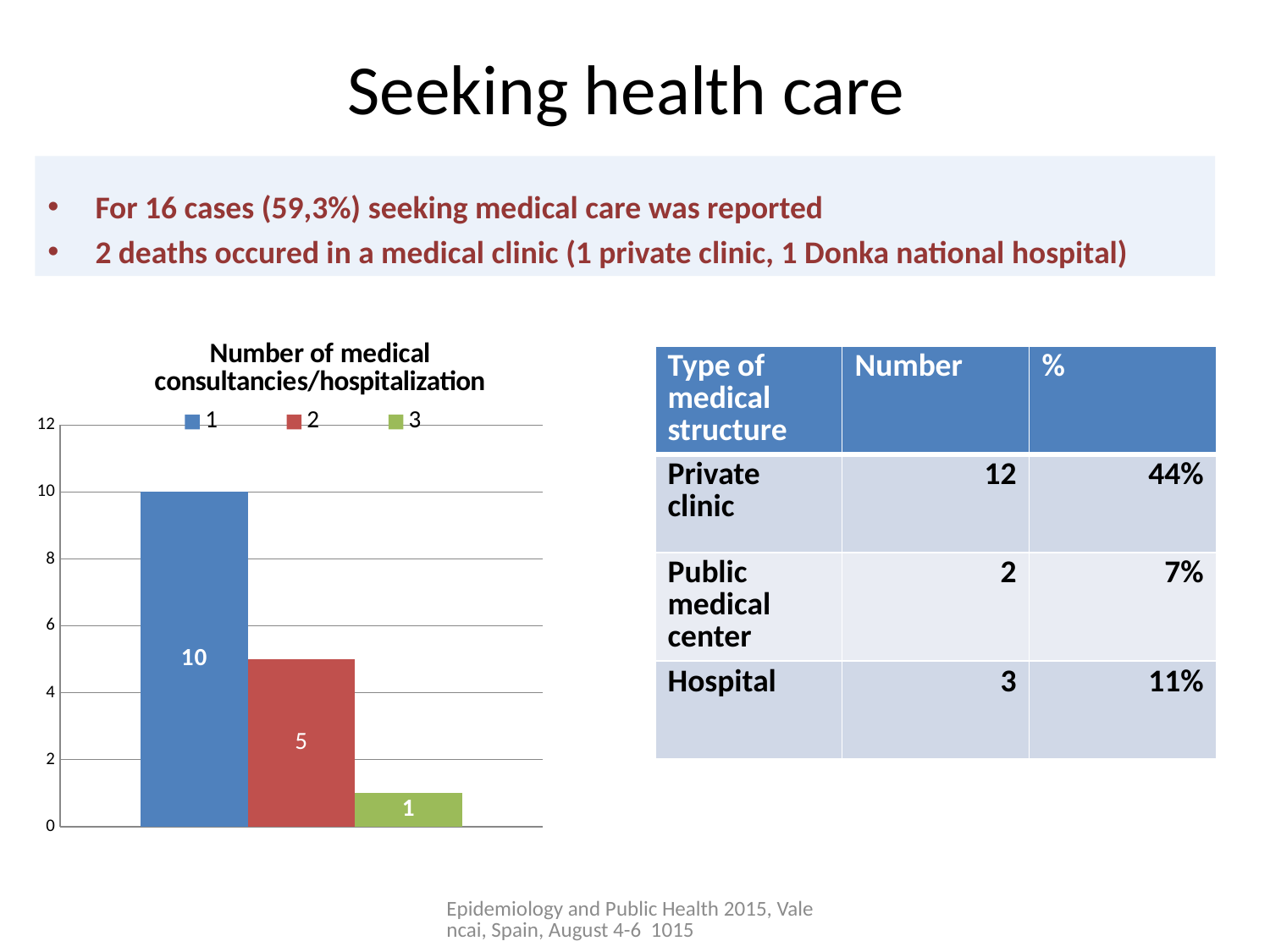
What is the value for series 2 in the chart? 5 Which is larger, the value for series 2 or series 3? 2 Which series has the highest value in the chart? 1 How many series does the legend list? 3 Is the value for series 1 greater or less than 8? greater What is the value for series 3 in the chart? 1 What colour is the bar for series 2? red Which series has the lowest value in the chart? 3 What is the value for series 1 in the chart? 10 What type of chart is shown on the slide? bar chart What is the difference between the values for series 1 and series 2? 5 What is the title of the chart? Number of medical consultancies/hospitalization